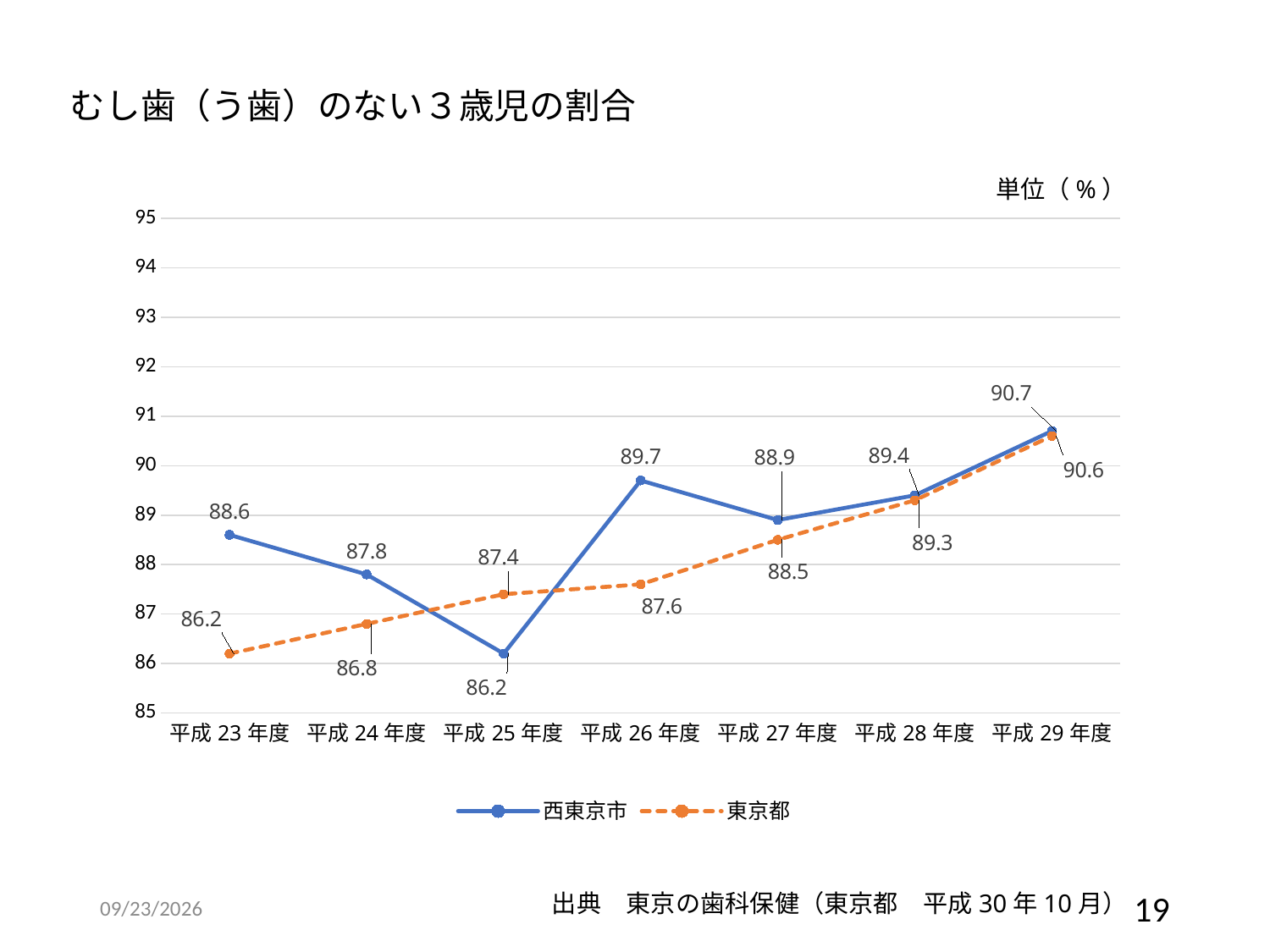
What is the value for 西東京市 in 平成25年度? 86.2 What kind of chart is shown on the slide? line chart Which series has the larger value in 平成25年度, 西東京市 or 東京都? 東京都 In which fiscal year is the value for 東京都 lowest? 平成23年度 Does the value for 東京都 rise or fall from 平成23年度 to 平成29年度? rise How many fiscal years are plotted along the x axis? 7 In which fiscal year is the value for 西東京市 highest? 平成29年度 What is the value for 西東京市 in 平成26年度? 89.7 How many series does the legend list? 2 What is the difference between 西東京市 and 東京都 in 平成23年度? 2.4 What is the value for 東京都 in 平成27年度? 88.5 Which series is drawn with a dashed line? 東京都